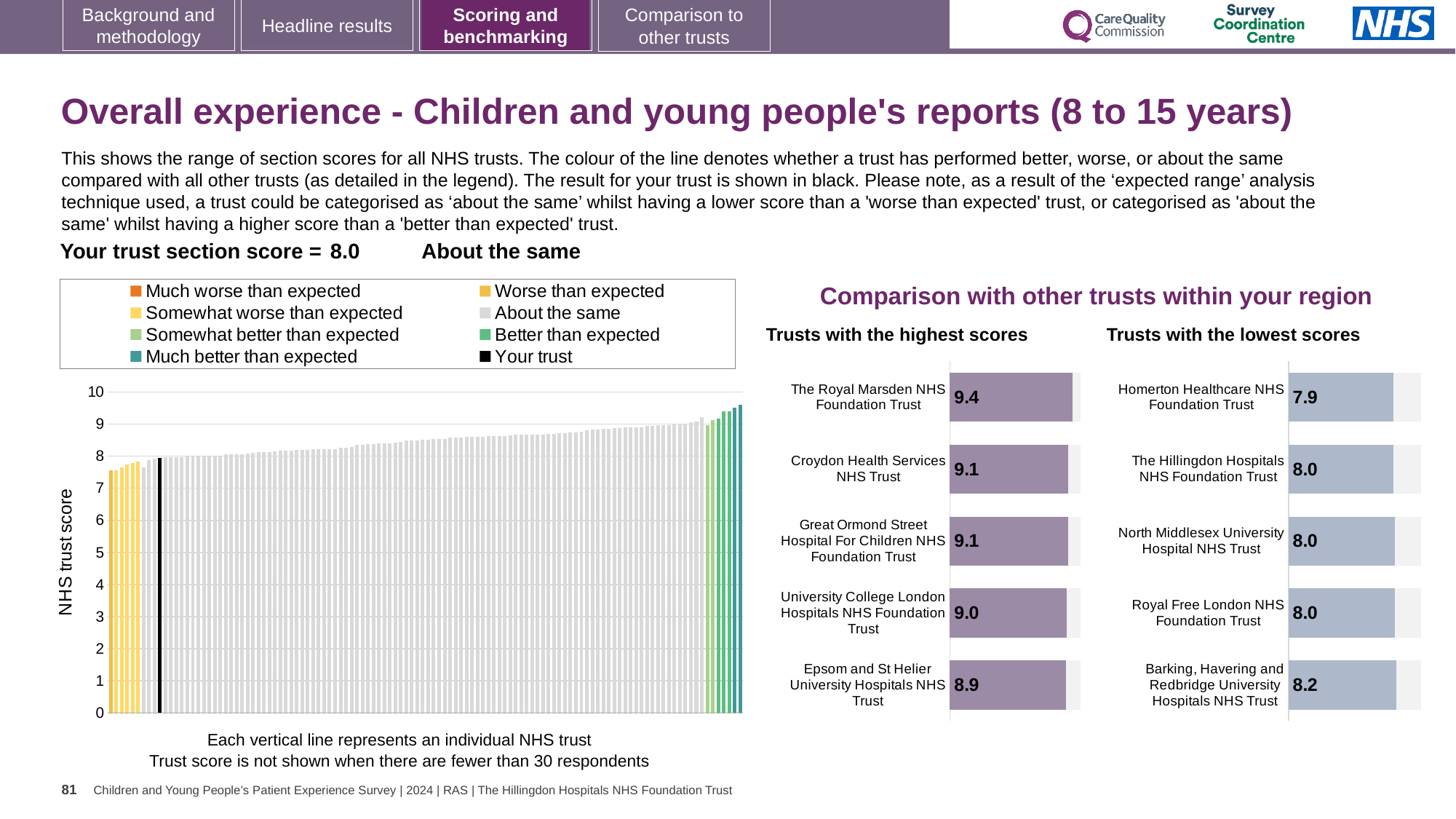
How many trusts are listed in the 'Trusts with the highest scores' chart? 5 What kind of chart is the large chart on the left with the y-axis labelled 'NHS trust score'? bar chart In the 'Trusts with the highest scores' chart, what is the score for The Royal Marsden NHS Foundation Trust? 9.4 In the 'Trusts with the lowest scores' chart, what is the score for Homerton Healthcare NHS Foundation Trust? 7.9 In the large chart on the left with the y-axis labelled 'NHS trust score', do the values rise or fall from left to right? rise In the 'Trusts with the highest scores' chart, what is the score for Epsom and St Helier University Hospitals NHS Trust? 8.9 How many entries does the legend above the large chart on the left list? 8 In the 'Trusts with the lowest scores' chart, which trust has the lowest score? Homerton Healthcare NHS Foundation Trust In the 'Trusts with the lowest scores' chart, which has the larger score: Barking, Havering and Redbridge University Hospitals NHS Trust or Homerton Healthcare NHS Foundation Trust? Barking, Havering and Redbridge University Hospitals NHS Trust According to the slide, what is your trust's section score shown in black on the large chart on the left? 8.0 In the 'Trusts with the highest scores' chart, which trust has the highest score? The Royal Marsden NHS Foundation Trust In the 'Trusts with the highest scores' chart, what is the difference between the scores of The Royal Marsden NHS Foundation Trust and Epsom and St Helier University Hospitals NHS Trust? 0.5